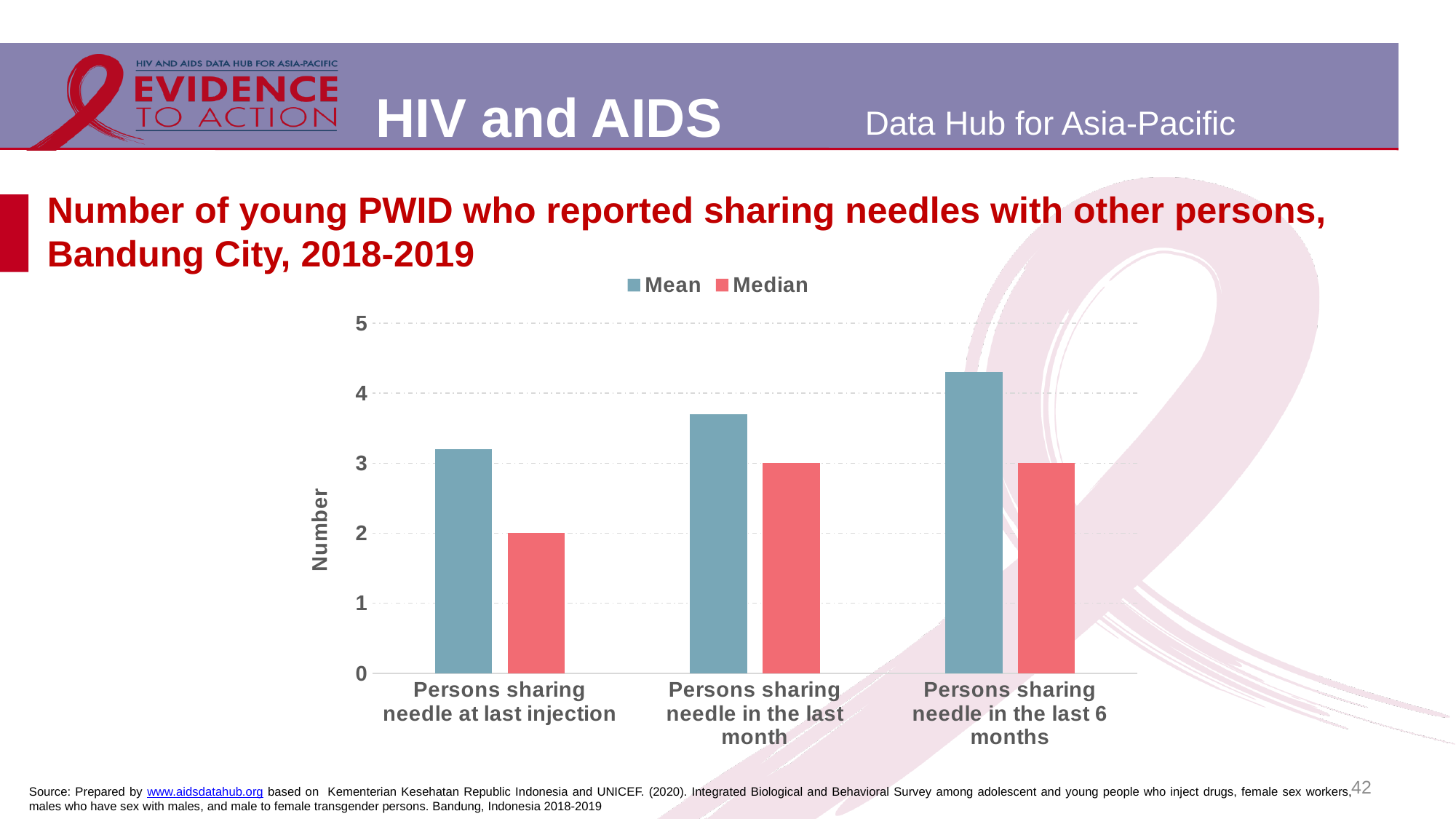
Is the Mean value for 'Persons sharing needle in the last 6 months' greater or less than 4? greater Is the Mean value for 'Persons sharing needle in the last month' greater or less than 4? less What is the Median value for 'Persons sharing needle in the last 6 months'? 3 How many categories are shown on the x axis? 3 Is the Mean value for 'Persons sharing needle at last injection' greater or less than 3? greater Which category has the lowest Median value? Persons sharing needle at last injection Which category has the highest Mean value? Persons sharing needle in the last 6 months How many series does the legend list? 2 What is the Median value for 'Persons sharing needle in the last month'? 3 What type of chart is shown on the slide? bar chart What are the two series named in the legend? Mean and Median What is the Median value for 'Persons sharing needle at last injection'? 2